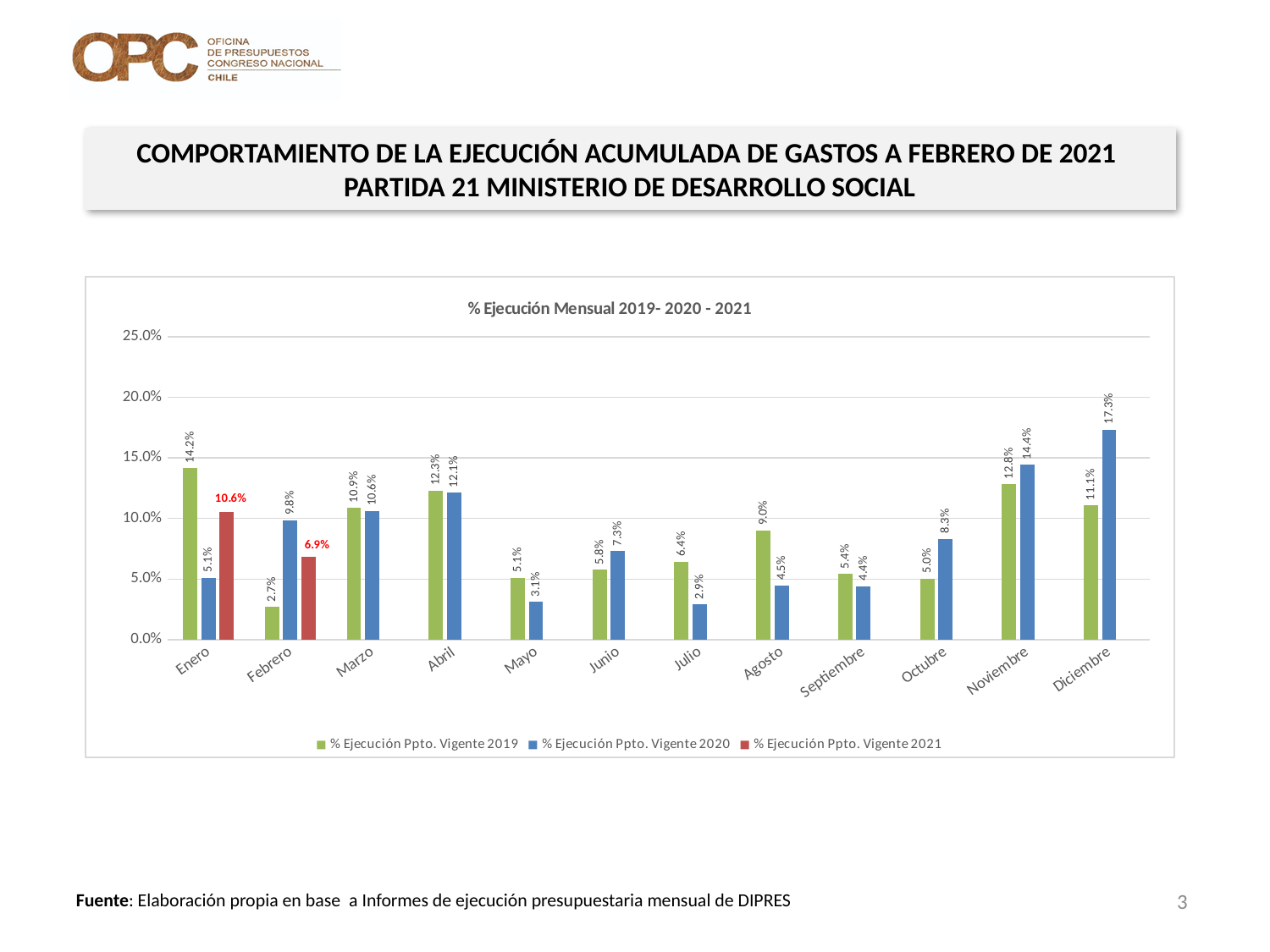
Which month has the highest value in the % Ejecución Ppto. Vigente 2020 series? Diciembre What is the value for Diciembre in the % Ejecución Ppto. Vigente 2020 series? 17.3% How many months are shown on the x axis? 12 Is the value for Noviembre in the 2020 series greater or less than 10.0%? greater How many series does the legend list? 3 What is the value for Enero in the % Ejecución Ppto. Vigente 2021 series? 10.6% What is the title of the chart? % Ejecución Mensual 2019- 2020 - 2021 Which is larger for Julio: the 2019 value or the 2020 value? 2019 value (6.4%) What is the value for Febrero in the % Ejecución Ppto. Vigente 2019 series? 2.7% What is the difference between the 2019 and 2020 values for Enero? 9.1% Which month has the lowest value in the % Ejecución Ppto. Vigente 2019 series? Febrero What kind of chart is shown on the slide? Bar chart